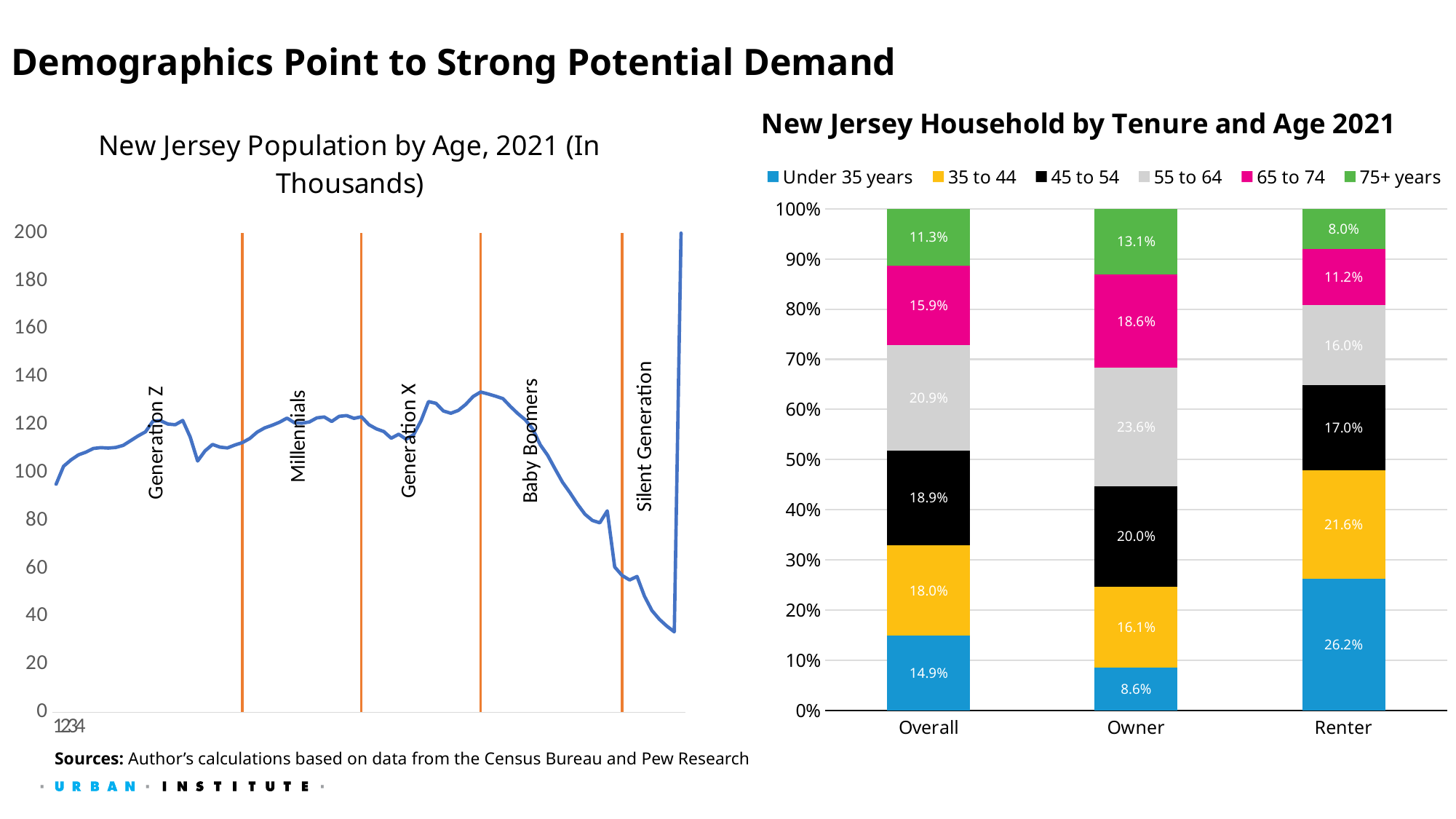
In the New Jersey Household by Tenure and Age 2021 chart, what is the share of Renter households headed by someone under 35 years? 26.2% In the New Jersey Household by Tenure and Age 2021 chart, what is the difference in percentage points between the Under 35 years share for Renter and for Owner? 17.6 percentage points How many generation labels are shown on the New Jersey Population by Age, 2021 chart? 5 How many age groups does the legend of the New Jersey Household by Tenure and Age 2021 chart list? 6 In the New Jersey Population by Age, 2021 chart, does the population generally rise or fall across the Baby Boomers section? Fall In the New Jersey Household by Tenure and Age 2021 chart, which tenure category has the lowest 75+ years share? Renter In the New Jersey Household by Tenure and Age 2021 chart, what is the 55 to 64 share for Owner households? 23.6% In the New Jersey Household by Tenure and Age 2021 chart, what is the 75+ years share for Overall households? 11.3% In the New Jersey Household by Tenure and Age 2021 chart, which tenure category has the highest Under 35 years share? Renter What kind of chart is the New Jersey Population by Age, 2021 chart on the left? Line chart How many tenure categories are shown on the x axis of the New Jersey Household by Tenure and Age 2021 chart? 3 In the New Jersey Household by Tenure and Age 2021 chart, is the 45 to 54 share larger for Owner or for Renter? Owner